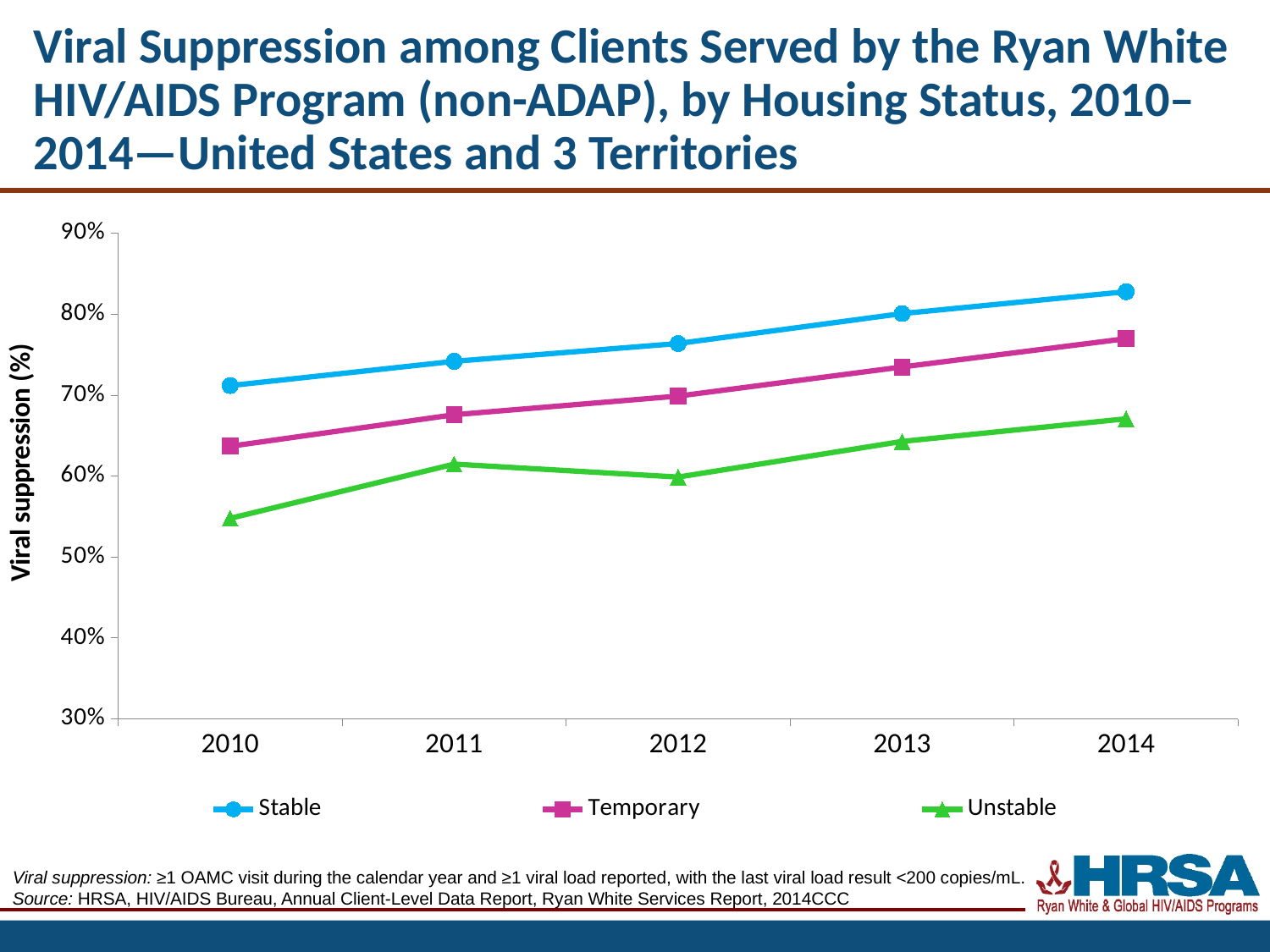
Is the value for Unstable in 2010 greater or less than 60%? less In 2012, which is larger: the value for Stable or the value for Unstable? Stable Is the value for Temporary in 2014 greater or less than 70%? greater Does the Stable series rise or fall from 2010 to 2014? Rise How many years are plotted along the x axis? 5 What is the label on the y axis? Viral suppression (%) Which housing status series has the lowest viral suppression in 2010? Unstable What kind of chart is shown on the slide? Line chart How many series does the legend list? 3 Is the value for Temporary in 2010 greater or less than 70%? less Which housing status series has the highest viral suppression in 2014? Stable